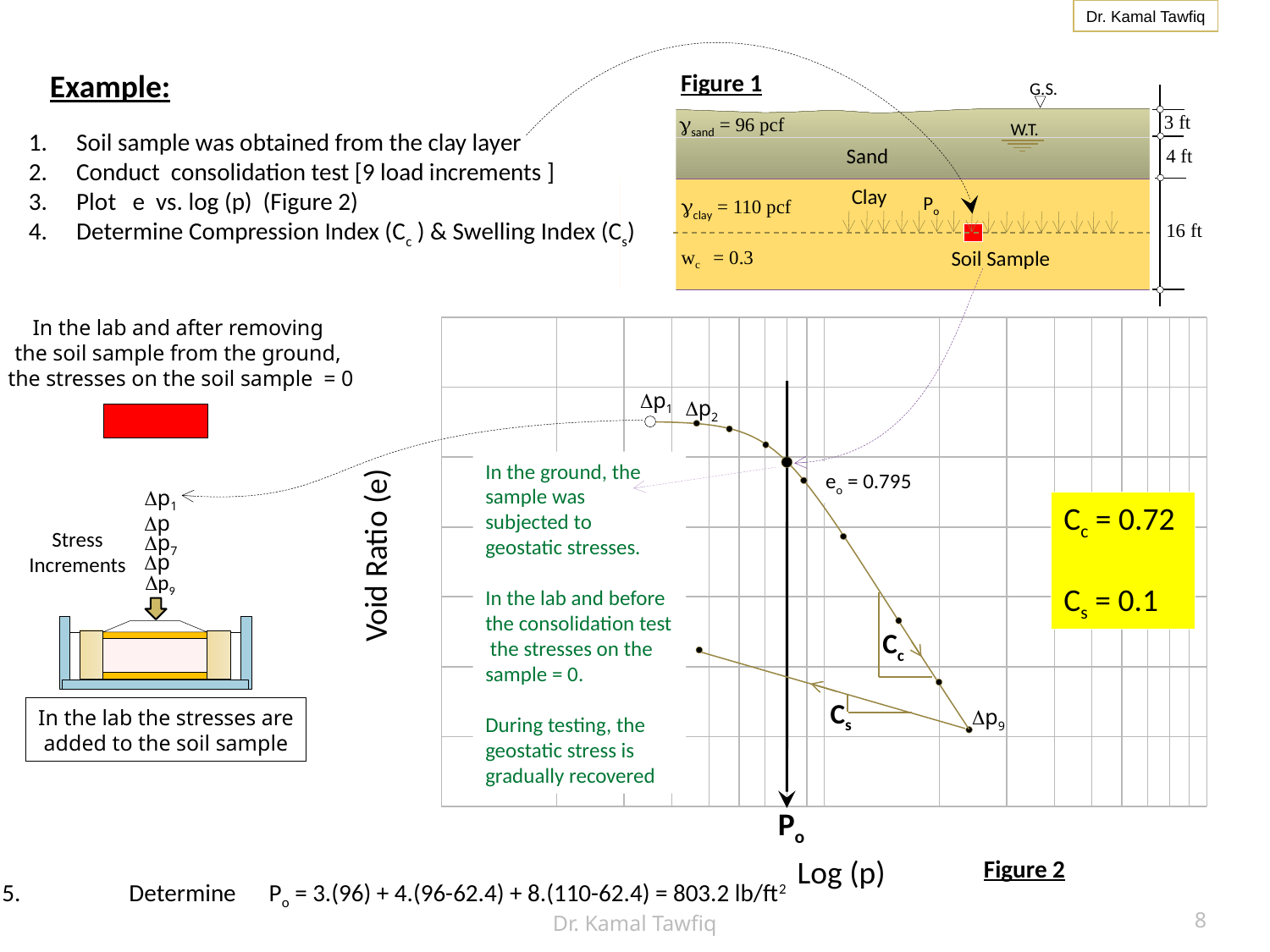
In Figure 2, what is the value of the Swelling Index C_s shown on the slide? 0.1 In Figure 2, what is the difference between C_c and C_s? 0.62 In Figure 2, which is larger, the Compression Index C_c or the Swelling Index C_s? C_c What is the value of P_o computed on the slide and marked by the vertical arrow in Figure 2? 803.2 lb/ft² In Figure 2, what is the label on the horizontal axis? Log (p) In Figure 2, what is the value of the initial void ratio e_o marked on the curve? 0.795 How many load increments were applied in the consolidation test plotted in Figure 2? 9 In Figure 2, what is the value of the Compression Index C_c shown on the slide? 0.72 What kind of chart is Figure 2? line chart In Figure 2, does the void ratio rise or fall as log(p) increases along the main loading curve? fall In Figure 2, what is the label on the vertical axis? Void Ratio (e) In Figure 2, which labelled stress increment point lies at the lowest void ratio? Δp9